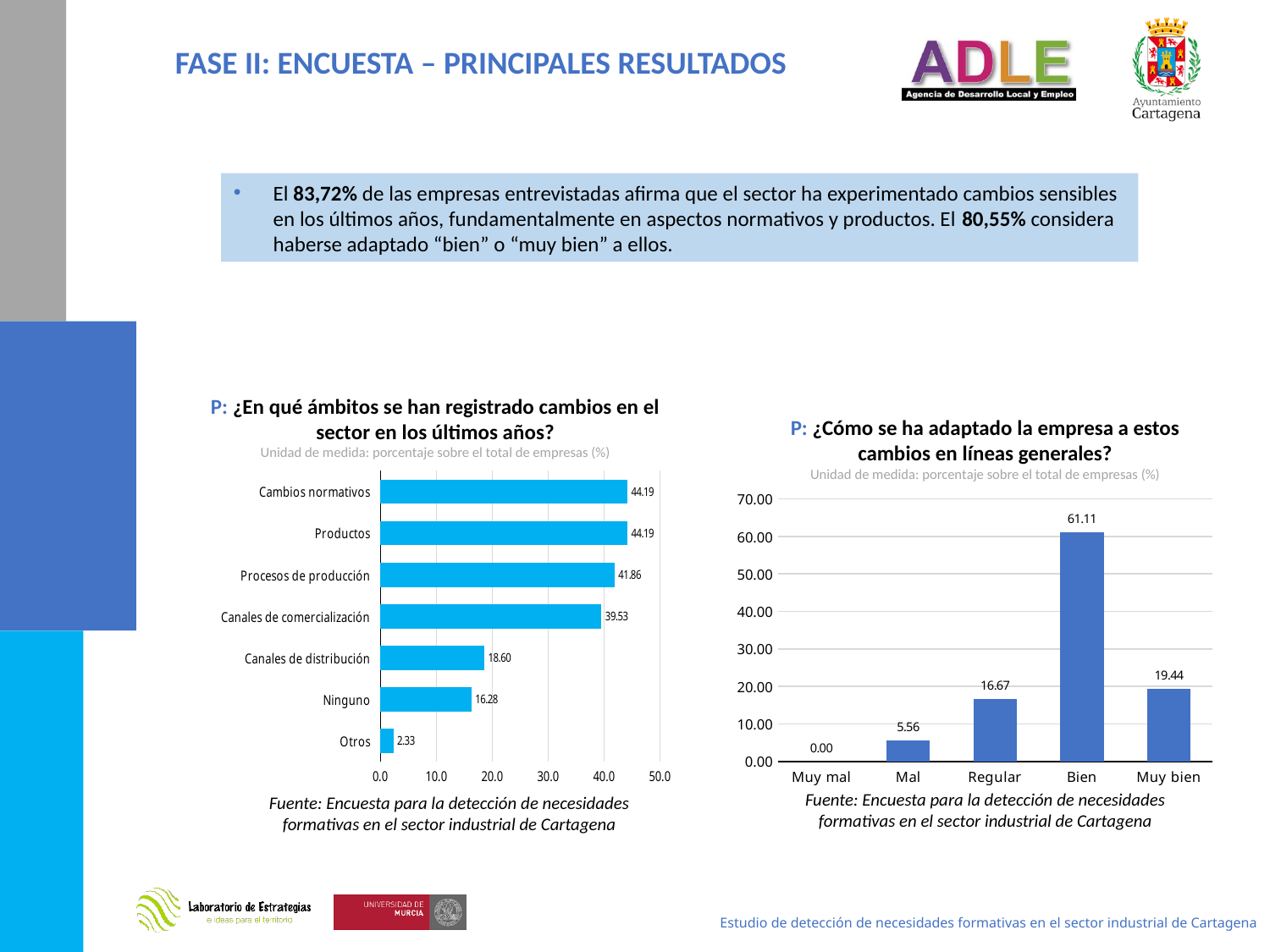
In the left chart (¿En qué ámbitos se han registrado cambios en el sector en los últimos años?), what is the value for Canales de distribución? 18.60 What kind of chart is the left chart (¿En qué ámbitos se han registrado cambios en el sector en los últimos años?)? Bar chart In the left chart (¿En qué ámbitos se han registrado cambios en el sector en los últimos años?), what is the value for Procesos de producción? 41.86 In the left chart (¿En qué ámbitos se han registrado cambios en el sector en los últimos años?), how many categories are shown? 7 In the right chart (¿Cómo se ha adaptado la empresa a estos cambios en líneas generales?), which category has the highest value? Bien In the left chart (¿En qué ámbitos se han registrado cambios en el sector en los últimos años?), which category has the lowest value? Otros In the right chart (¿Cómo se ha adaptado la empresa a estos cambios en líneas generales?), what is the value for Mal? 5.56 In the right chart (¿Cómo se ha adaptado la empresa a estos cambios en líneas generales?), what is the difference between Bien and Muy bien? 41.67 In the right chart (¿Cómo se ha adaptado la empresa a estos cambios en líneas generales?), which is larger, Regular or Muy bien? Muy bien In the right chart (¿Cómo se ha adaptado la empresa a estos cambios en líneas generales?), how many categories are shown on the x axis? 5 In the right chart (¿Cómo se ha adaptado la empresa a estos cambios en líneas generales?), what is the value for Bien? 61.11 In the left chart (¿En qué ámbitos se han registrado cambios en el sector en los últimos años?), what is the difference between Canales de comercialización and Ninguno? 23.25